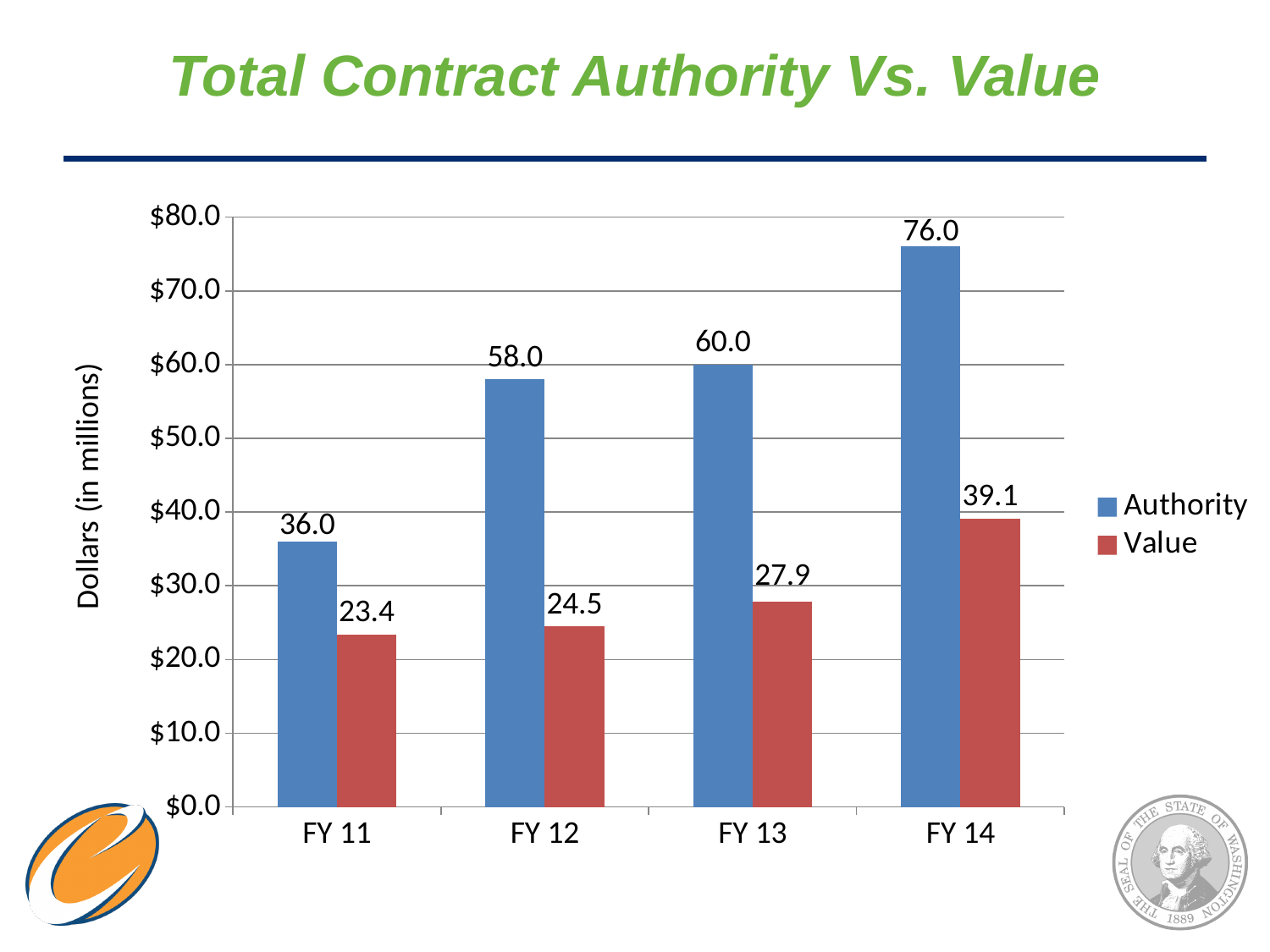
Which fiscal year has the lowest Value? FY 11 How many series does the legend list? 2 What kind of chart is shown on the slide? Bar chart What is the Authority value for FY 12? 58.0 What is the label on the vertical axis? Dollars (in millions) Which fiscal year has the highest Authority? FY 14 Which is larger in FY 11, Authority or Value? Authority What is the Value figure for FY 13? 27.9 Is the Authority value for FY 13 greater or less than $50.0? greater Does the Authority series rise or fall from FY 11 to FY 14? Rise How many fiscal years are shown on the x axis? 4 What is the difference between Authority and Value in FY 14? 36.9